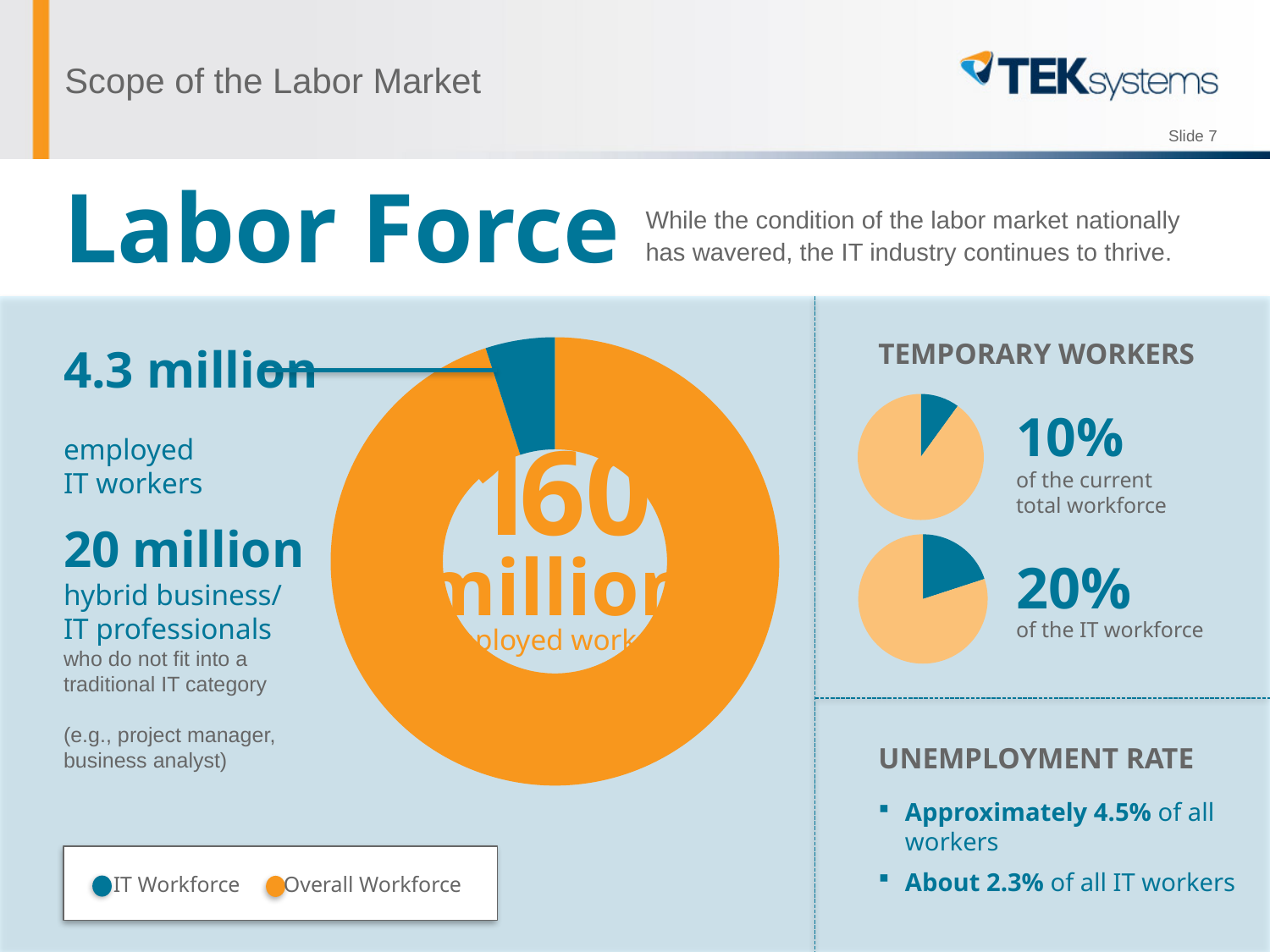
What is the heading above the two small pie charts on the right of the slide? TEMPORARY WORKERS In the Temporary Workers section, what share of the IT workforce is shown in the bottom small pie chart? 20% In the large chart, what value is given for the IT Workforce slice (employed IT workers)? 4.3 million What value is printed in the centre of the large chart for employed workers? 160 million In the Temporary Workers section, what share of the current total workforce is shown in the top small pie chart? 10% What kind of chart is the large chart in the centre of the slide? doughnut chart How many entries does the legend below the large chart list? 2 According to the legend, what colour represents the IT Workforce in the large chart? blue In the large chart, which slice is larger, IT Workforce or Overall Workforce? Overall Workforce In the Temporary Workers section, which small pie chart has the larger highlighted slice, the one for the total workforce or the one for the IT workforce? the IT workforce In the Temporary Workers section, what is the difference between the IT workforce share (20%) and the total workforce share (10%)? 10 percentage points How many pie charts are shown on the slide in total? 2